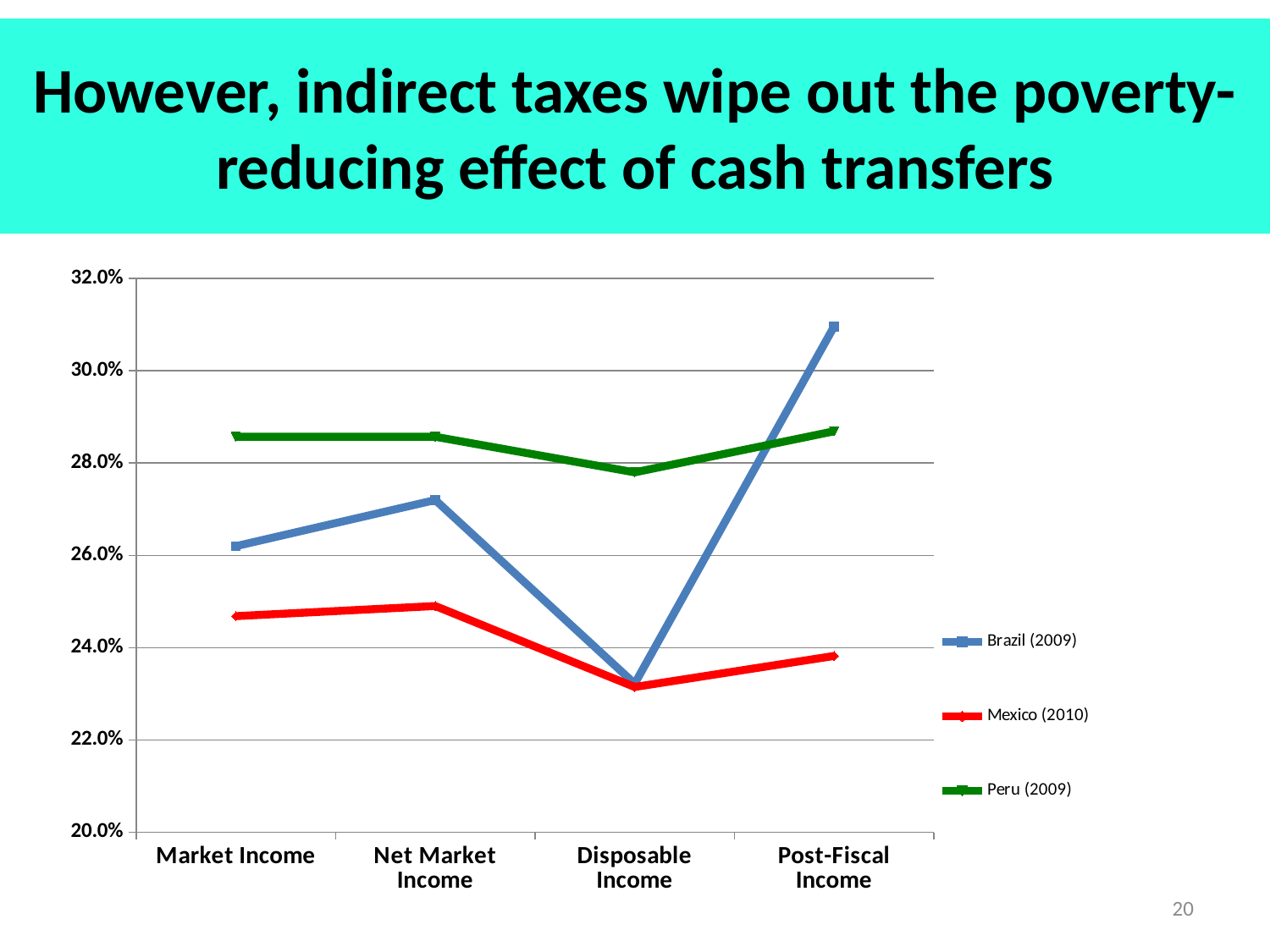
Which series has the highest value at Post-Fiscal Income? Brazil (2009) At Net Market Income, which is larger: the value for Peru (2009) or the value for Brazil (2009)? Peru (2009) What kind of chart is shown on the slide? line chart Is the value for Brazil (2009) at Net Market Income greater or less than 26.0%? greater Does the Brazil (2009) line rise or fall from Disposable Income to Post-Fiscal Income? rise Is the value for Peru (2009) at Market Income greater or less than 28.0%? greater Is the value for Brazil (2009) at Post-Fiscal Income greater or less than 30.0%? greater How many series does the legend list? 3 Which series is shown in red in the legend? Mexico (2010) How many income categories are shown on the x axis? 4 Which series has the lowest value at Market Income? Mexico (2010)